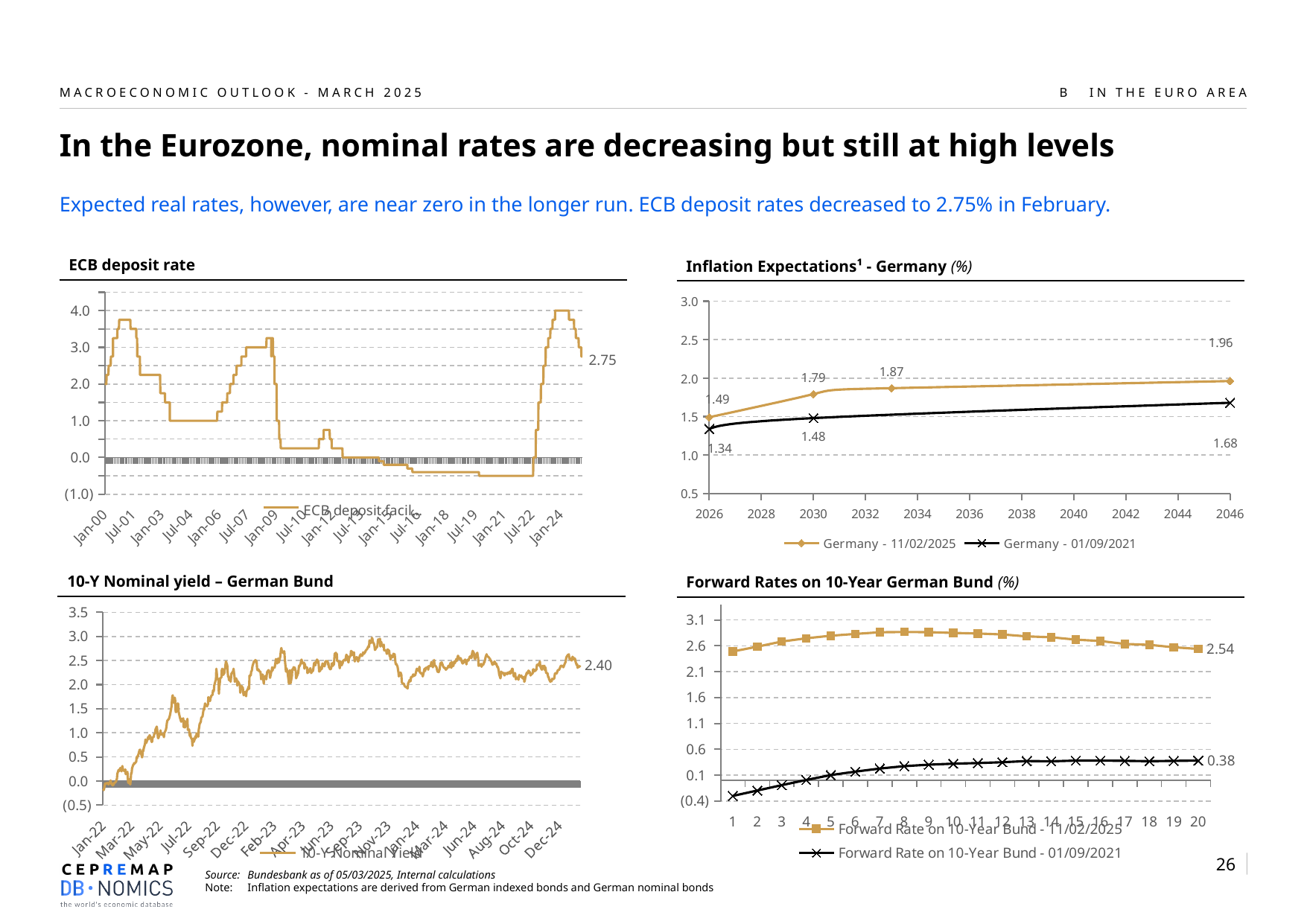
On the Inflation Expectations - Germany chart, what is the value for Germany - 11/02/2025 in 2046? 1.96 How many series does the legend of the Inflation Expectations - Germany chart list? 2 On the Inflation Expectations - Germany chart, what is the value for Germany - 01/09/2021 in 2030? 1.48 On the ECB deposit rate chart, what is the latest value labelled at the end of the line? 2.75 What kind of chart is the ECB deposit rate chart? line chart On the Forward Rates on 10-Year German Bund chart, what is the difference between the two series' values at year 20? 2.16 On the Inflation Expectations - Germany chart, what is the difference between the Germany - 11/02/2025 and Germany - 01/09/2021 values in 2046? 0.28 On the 10-Y Nominal yield – German Bund chart, is the value at Jan-22 greater or less than 0.5? less On the Inflation Expectations - Germany chart, which series has the higher value in 2030? Germany - 11/02/2025 On the 10-Y Nominal yield – German Bund chart, what is the latest value labelled at the end of the line? 2.40 On the Forward Rates on 10-Year German Bund chart, what is the value at year 20 for Forward Rate on 10-Year Bund - 01/09/2021? 0.38 On the Forward Rates on 10-Year German Bund chart, is the value at year 1 for Forward Rate on 10-Year Bund - 11/02/2025 greater or less than 2.1? greater